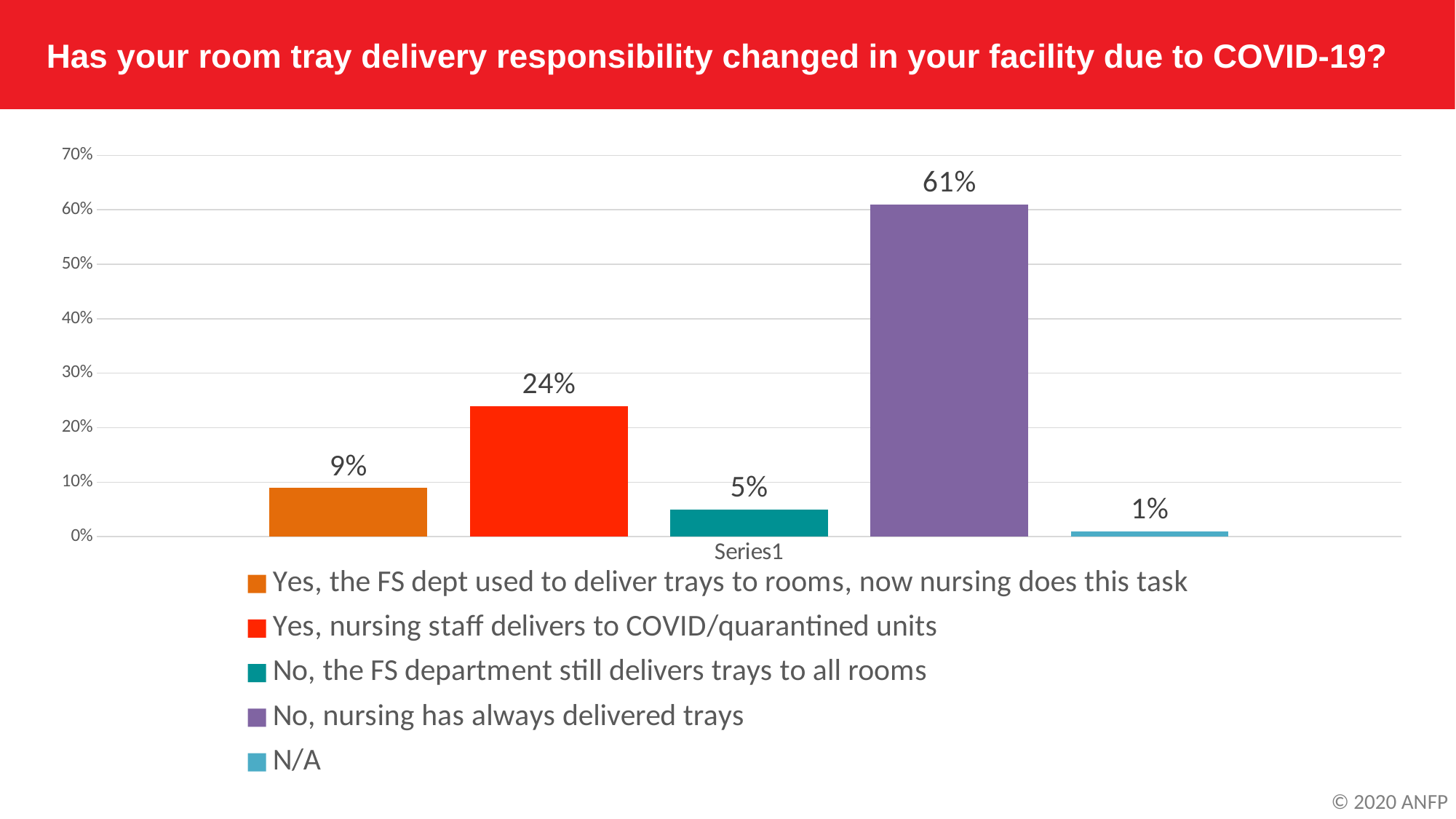
What percentage of respondents said "Yes, the FS dept used to deliver trays to rooms, now nursing does this task"? 9% What percentage of respondents said "Yes, nursing staff delivers to COVID/quarantined units"? 24% What colour is the bar for "No, nursing has always delivered trays"? Purple Which response has the highest percentage? No, nursing has always delivered trays Which is larger: the percentage for "Yes, the FS dept used to deliver trays to rooms, now nursing does this task" or for "No, the FS department still delivers trays to all rooms"? Yes, the FS dept used to deliver trays to rooms, now nursing does this task What is the title of the chart? Has your room tray delivery responsibility changed in your facility due to COVID-19? What percentage of respondents said "No, nursing has always delivered trays"? 61% What percentage of respondents answered N/A? 1% How many response categories are shown in the chart? 5 Which response has the lowest percentage? N/A What is the difference in percentage points between "No, nursing has always delivered trays" and "Yes, nursing staff delivers to COVID/quarantined units"? 37 percentage points What kind of chart is shown on the slide? Bar chart